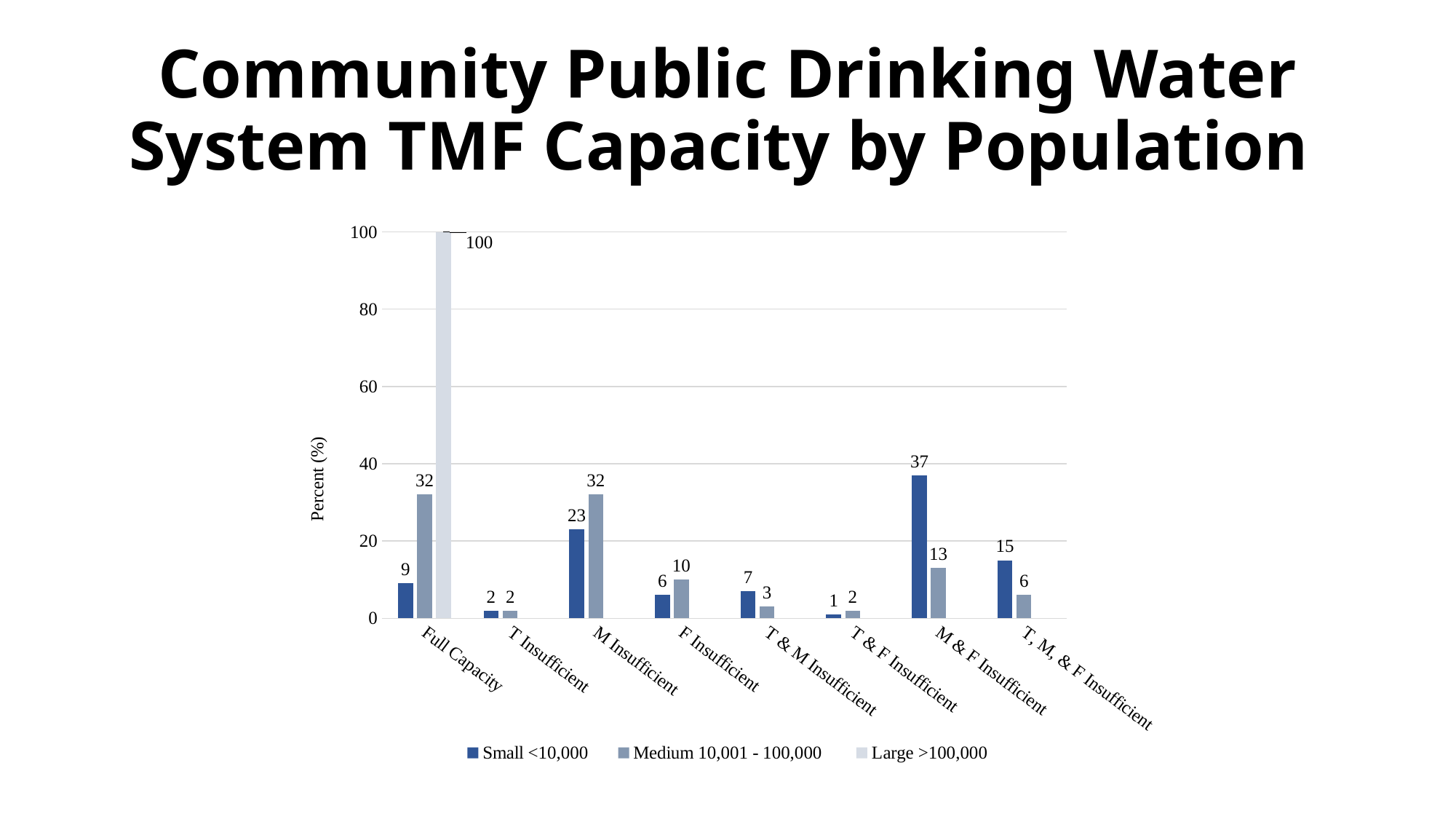
What is the difference between the Small <10,000 and Medium 10,001 - 100,000 values in the M & F Insufficient category? 24 What is the label of the y axis? Percent (%) What is the value for Medium 10,001 - 100,000 in the T, M, & F Insufficient category? 6 Which category has the highest value for the Small <10,000 series? M & F Insufficient How many series does the legend list? 3 In the F Insufficient category, which series has the larger value, Small <10,000 or Medium 10,001 - 100,000? Medium 10,001 - 100,000 What is the value for Large >100,000 in the Full Capacity category? 100 What kind of chart is shown on the slide? Bar chart Which category has the lowest value for the Small <10,000 series? T & F Insufficient How many categories are shown on the x axis? 8 What is the value for Small <10,000 in the Full Capacity category? 9 What is the value for Medium 10,001 - 100,000 in the M Insufficient category? 32